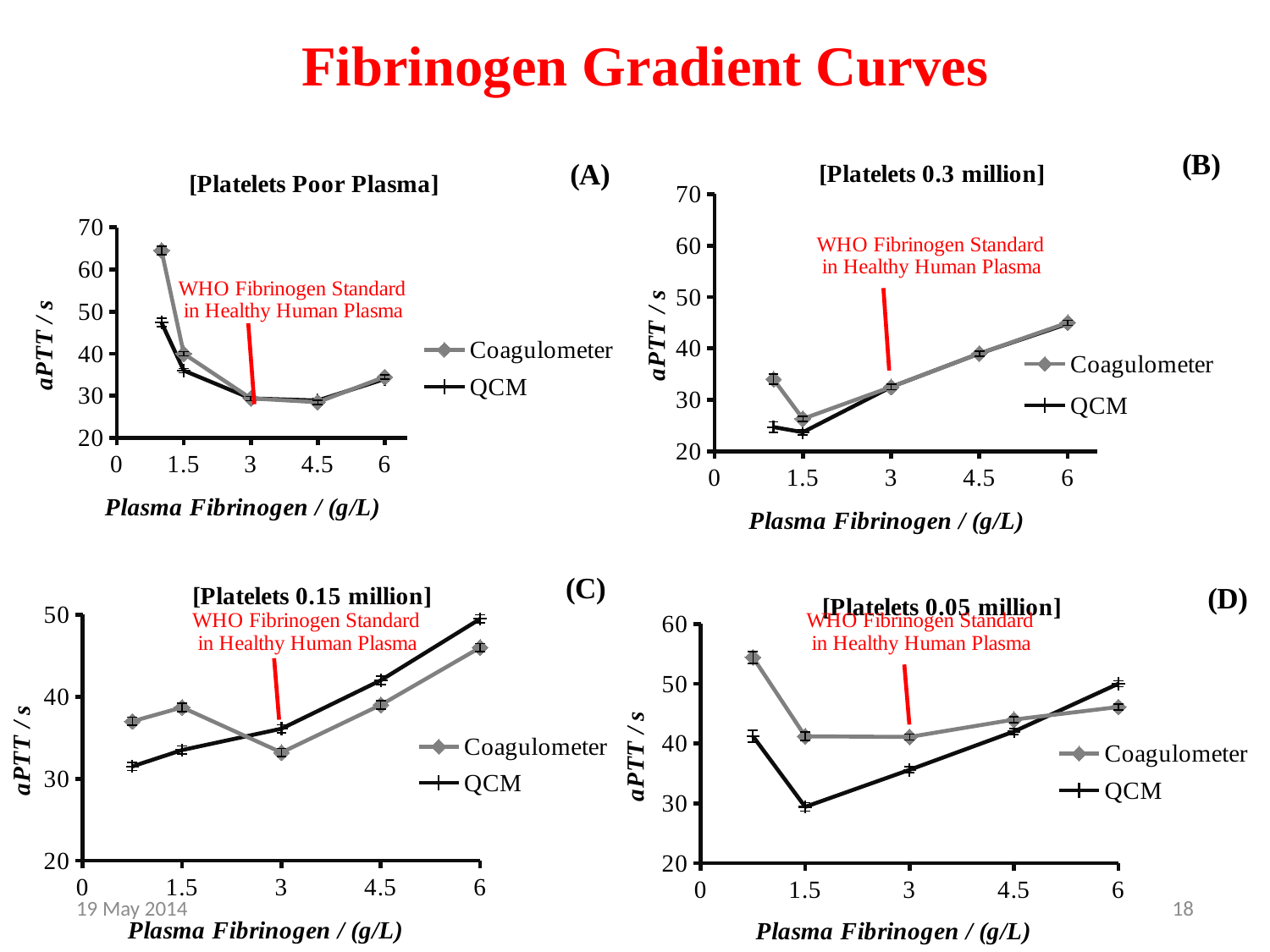
In the [Platelets 0.05 million] chart (D), at which plasma fibrinogen concentration is the QCM aPTT lowest? 1.5 In the [Platelets 0.3 million] chart (B), does the QCM aPTT rise or fall from 1.5 g/L to 6 g/L? rise In the [Platelets Poor Plasma] chart (A), at the lowest fibrinogen concentration, which series has the higher aPTT: Coagulometer or QCM? Coagulometer In the [Platelets 0.15 million] chart (C), is the Coagulometer value at 3 g/L greater or less than 35? less In the [Platelets Poor Plasma] chart (A), how many series does the legend list? 2 In the [Platelets 0.3 million] chart (B), at which plasma fibrinogen concentration is the Coagulometer aPTT highest? 6 What is the y-axis label on the [Platelets 0.05 million] chart (D)? aPTT / s What kind of chart is the [Platelets Poor Plasma] chart (A)? line chart In the [Platelets Poor Plasma] chart (A), how many data points does the Coagulometer series have? 5 In the [Platelets 0.15 million] chart (C), at 6 g/L, which series has the higher aPTT: Coagulometer or QCM? QCM In the [Platelets 0.3 million] chart (B), is the QCM value at 1.5 g/L greater or less than 30? less In the [Platelets Poor Plasma] chart (A), is the Coagulometer value at the lowest fibrinogen concentration greater or less than 60? greater